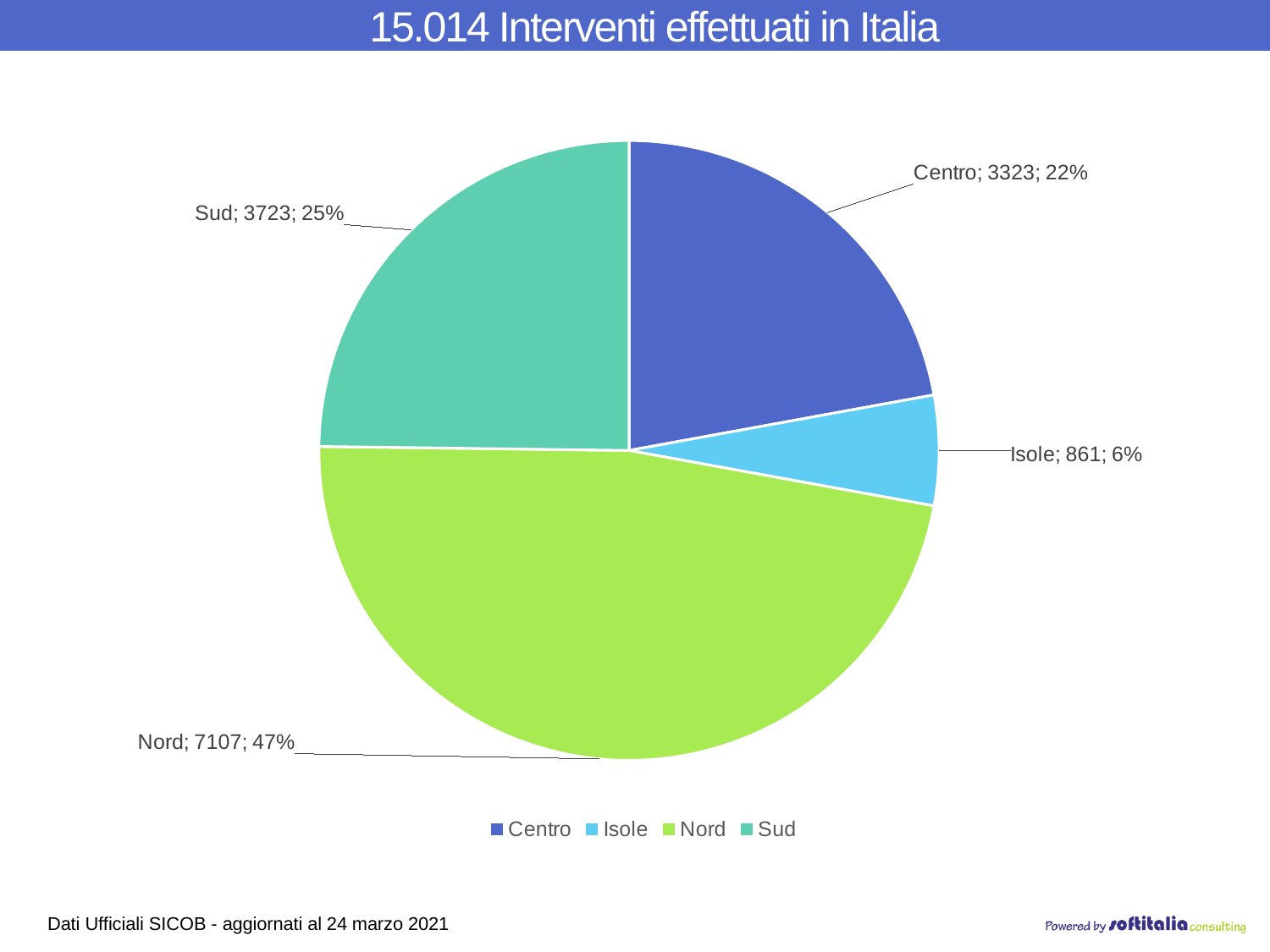
What is the value for Isole? 861 What is the title of the chart? 15.014 Interventi effettuati in Italia What share of the pie does Centro represent? 22% Which region has the smallest slice? Isole What is the value for Centro? 3323 What kind of chart is shown on the slide? pie chart Which region has the largest slice? Nord What is the value for Nord? 7107 What share of the pie does Sud represent? 25% How many slices does the pie chart have? 4 What is the difference between the values for Sud and Centro? 400 What is the value for Sud? 3723